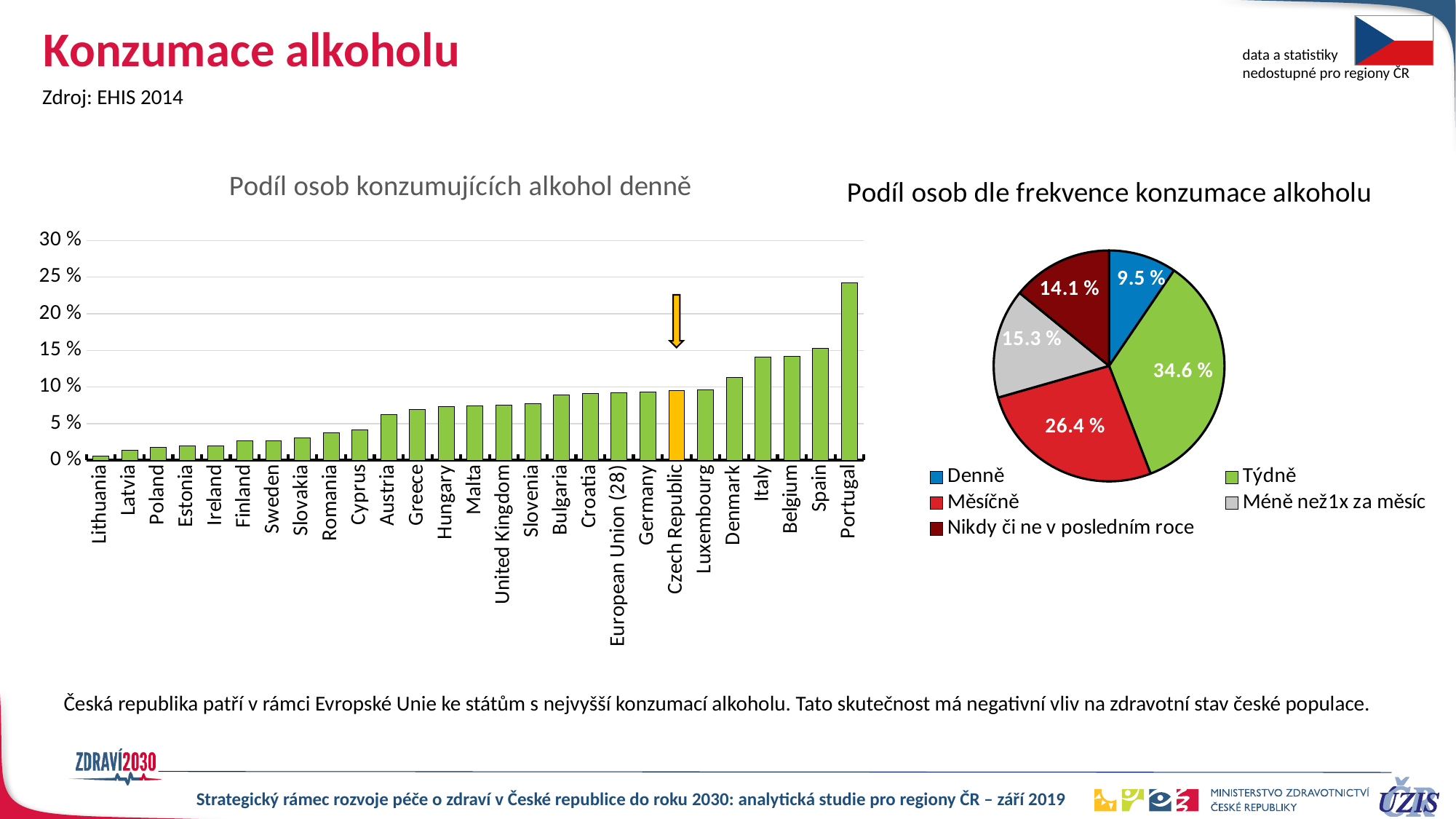
In the chart "Podíl osob konzumujících alkohol denně", is the value for Czech Republic greater or less than 5 %? greater How many bars are shown in the chart "Podíl osob konzumujících alkohol denně"? 27 In the chart "Podíl osob konzumujících alkohol denně", which country has the highest value? Portugal What kind of chart is "Podíl osob konzumujících alkohol denně"? bar chart In the chart "Podíl osob konzumujících alkohol denně", do the values rise or fall from left to right along the x axis? rise In the chart "Podíl osob konzumujících alkohol denně", which bar is highlighted in orange? Czech Republic In the pie chart "Podíl osob dle frekvence konzumace alkoholu", which category has the smallest share? Denně In the pie chart "Podíl osob dle frekvence konzumace alkoholu", what is the difference between Měsíčně and Denně? 16.9 % In the pie chart "Podíl osob dle frekvence konzumace alkoholu", what is the share for Týdně? 34.6 % In the chart "Podíl osob konzumujících alkohol denně", is the value for Portugal greater or less than 20 %? greater In the pie chart "Podíl osob dle frekvence konzumace alkoholu", which is larger: Méně než 1x za měsíc or Nikdy či ne v posledním roce? Méně než 1x za měsíc In the chart "Podíl osob konzumujících alkohol denně", which country has the lowest value? Lithuania